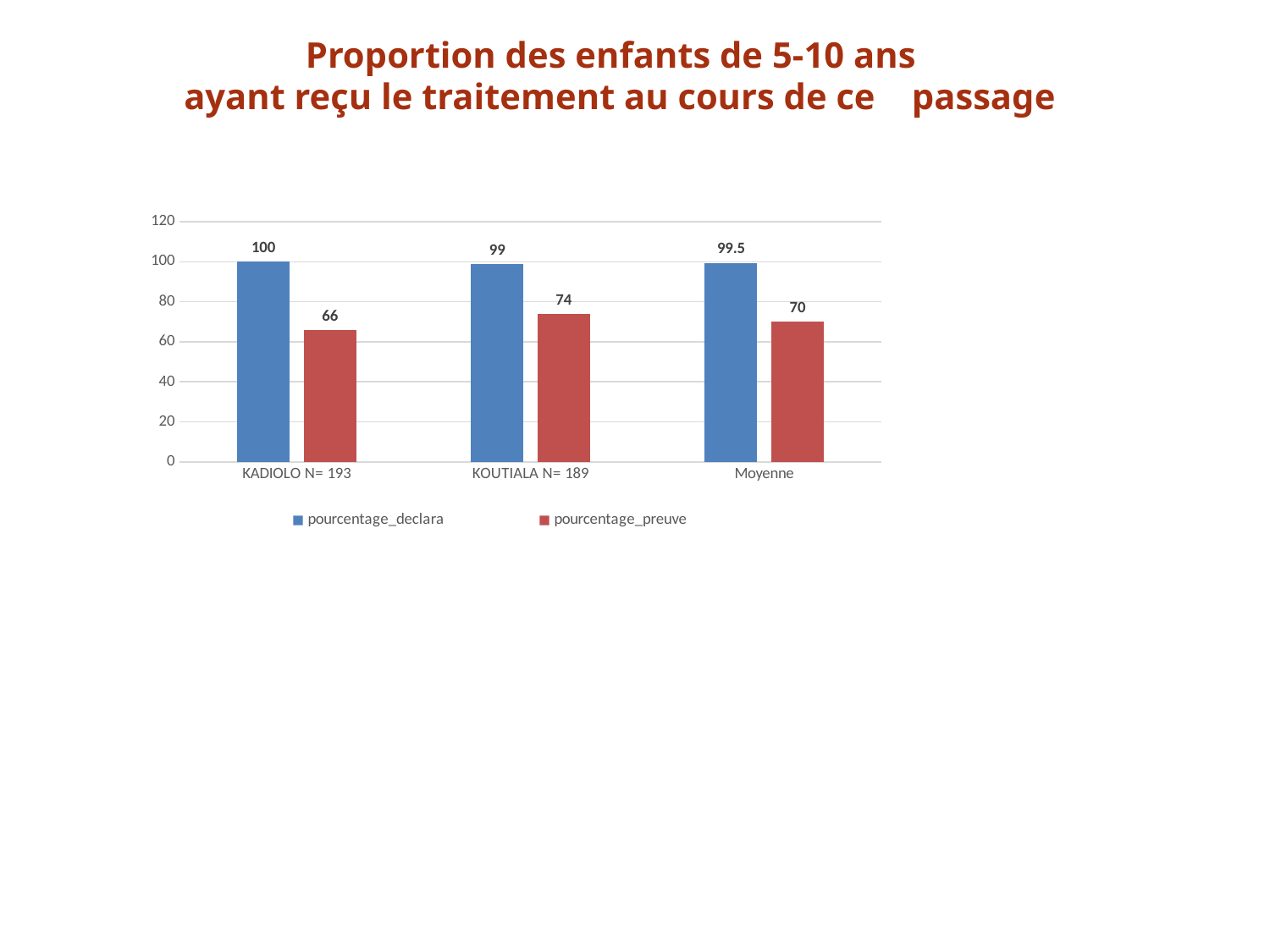
What is the difference between the pourcentage_preuve values for KOUTIALA N= 189 and KADIOLO N= 193? 8 Which is larger: pourcentage_preuve for KOUTIALA N= 189 or pourcentage_preuve for Moyenne? KOUTIALA N= 189 How many categories are shown on the x axis? 3 What kind of chart is shown on the slide? Bar chart What is the pourcentage_preuve value for Moyenne? 70 What is the pourcentage_preuve value for KOUTIALA N= 189? 74 What is the pourcentage_declara value for KADIOLO N= 193? 100 How many series does the legend list? 2 Which category has the lowest pourcentage_preuve value? KADIOLO N= 193 What is the pourcentage_declara value for Moyenne? 99.5 What is the difference between pourcentage_declara and pourcentage_preuve for KADIOLO N= 193? 34 Which category has the highest pourcentage_preuve value? KOUTIALA N= 189